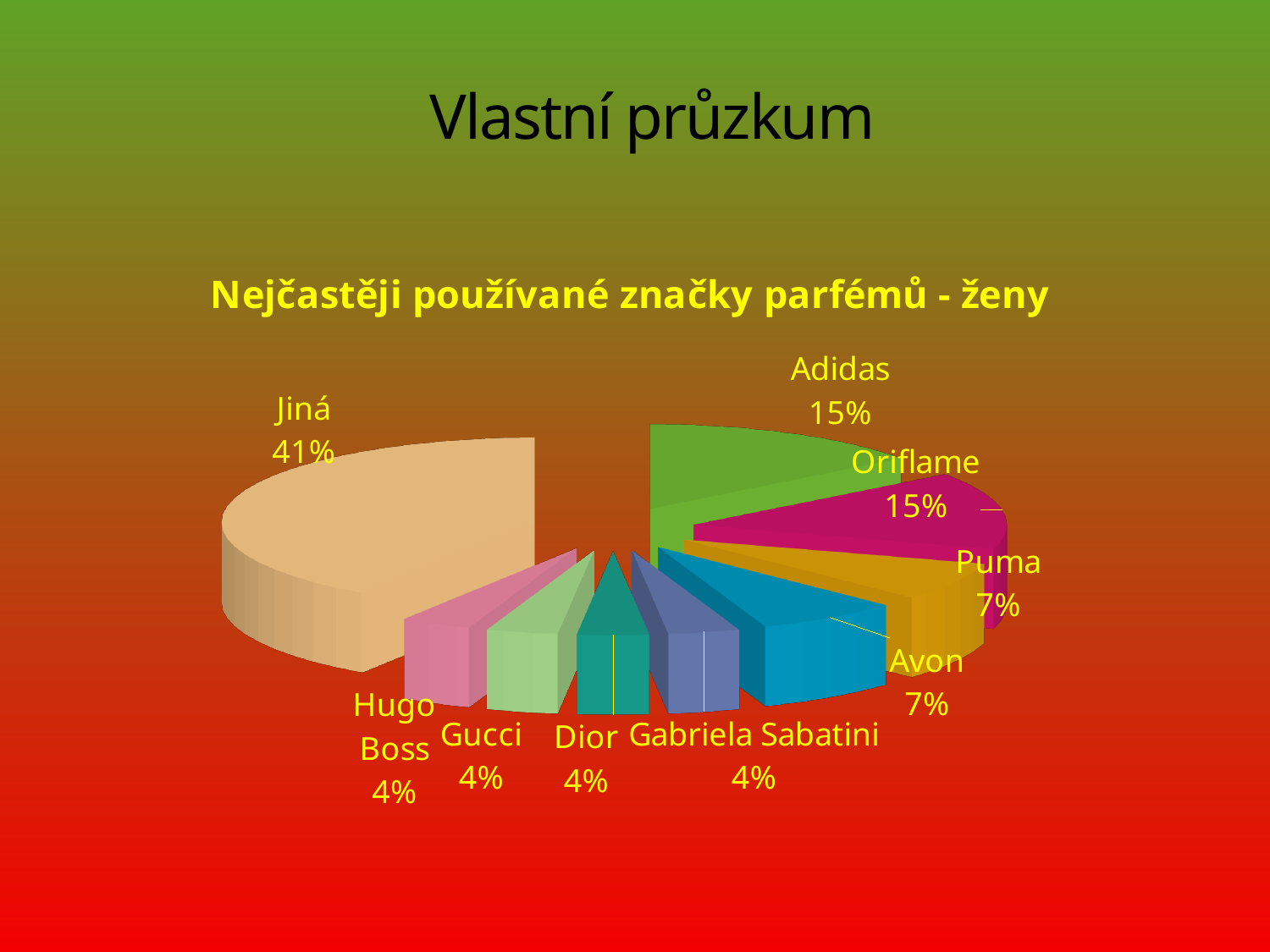
What percentage is shown for Gabriela Sabatini? 4% How many slices does the pie chart have? 9 What percentage is shown for Adidas? 15% What share of the pie does Jiná have? 41% What is the difference in percentage points between Jiná and Oriflame? 26 What kind of chart is shown on the slide? pie chart Which is larger, the share for Avon or the share for Gucci? Avon Which category has the largest slice of the pie? Jiná What percentage is shown for Hugo Boss? 4% What percentage is shown for Puma? 7% What is the title of the chart? Nejčastěji používané značky parfémů - ženy What is the difference in percentage points between Adidas and Puma? 8